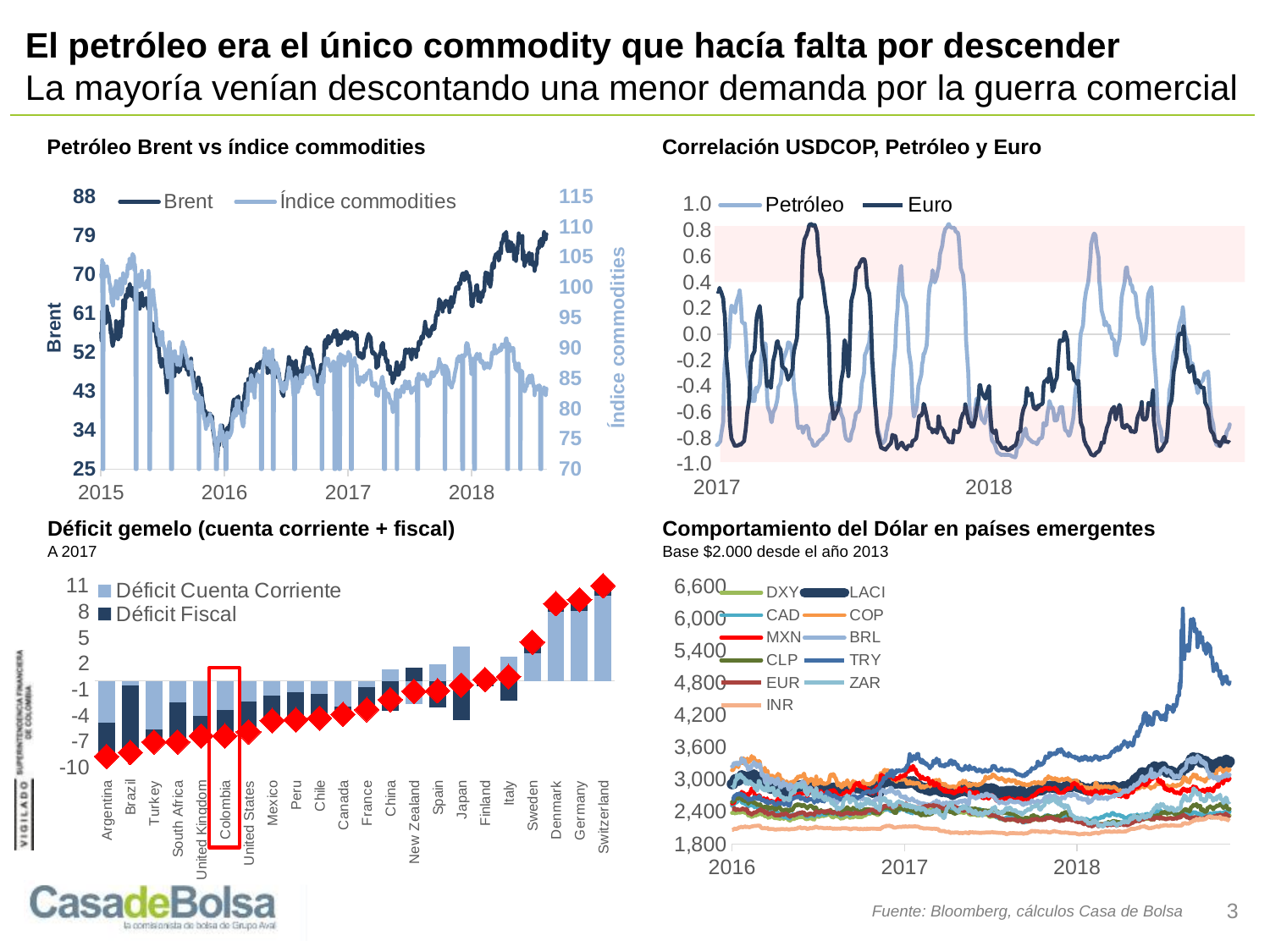
In the chart titled 'Petróleo Brent vs índice commodities', how many series does the legend list? 2 In the chart titled 'Déficit gemelo (cuenta corriente + fiscal)', which country has the highest combined value? Switzerland In the chart titled 'Correlación USDCOP, Petróleo y Euro', what is the highest value shown on the y axis? 1.0 In the chart titled 'Déficit gemelo (cuenta corriente + fiscal)', which country has the lowest combined deficit? Argentina In the chart titled 'Déficit gemelo (cuenta corriente + fiscal)', how many countries are shown on the x axis? 22 In the chart titled 'Déficit gemelo (cuenta corriente + fiscal)', is the combined value for Argentina greater or less than -7? less In the chart titled 'Comportamiento del Dólar en países emergentes', is the peak value of the TRY series in 2018 greater or less than 5,400? greater What kind of chart is 'Petróleo Brent vs índice commodities'? Line chart In the chart titled 'Petróleo Brent vs índice commodities', is the Brent value at the end of the series greater or less than 70? greater In the chart titled 'Correlación USDCOP, Petróleo y Euro', which two series are shown in the legend? Petróleo and Euro In the chart titled 'Petróleo Brent vs índice commodities', does the Brent series rise or fall between 2017 and 2018? Rise In the chart titled 'Comportamiento del Dólar en países emergentes', how many series does the legend list? 11